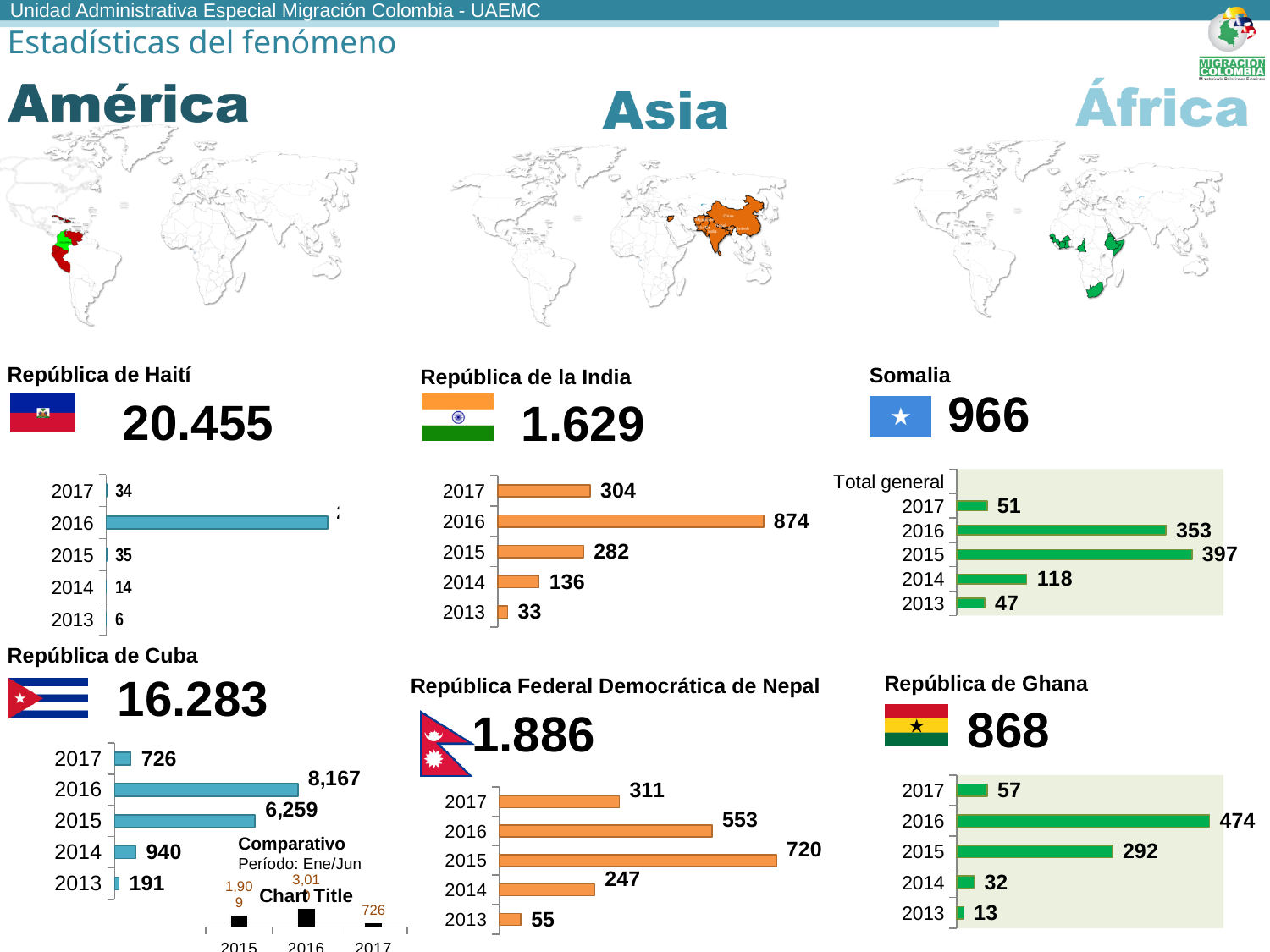
In the República de Haití chart, what is the value for 2014? 14 In the República Federal Democrática de Nepal chart, what is the value for 2013? 55 What kind of chart is the República de Ghana chart? bar chart In the República Federal Democrática de Nepal chart, which year has the highest value? 2015 In the República de la India chart, which year has the lowest value? 2013 In the Somalia chart, which year has the highest value? 2015 In the República de Cuba chart, which is larger, the value for 2015 or the value for 2017? 2015 In the República de Cuba chart, what is the value for 2016? 8,167 In the Somalia chart, what is the value for 2014? 118 In the República de Ghana chart, what is the difference between the 2016 and 2015 values? 182 In the República de la India chart, what is the difference between the 2016 and 2017 values? 570 In the República de la India chart, what is the value for 2016? 874